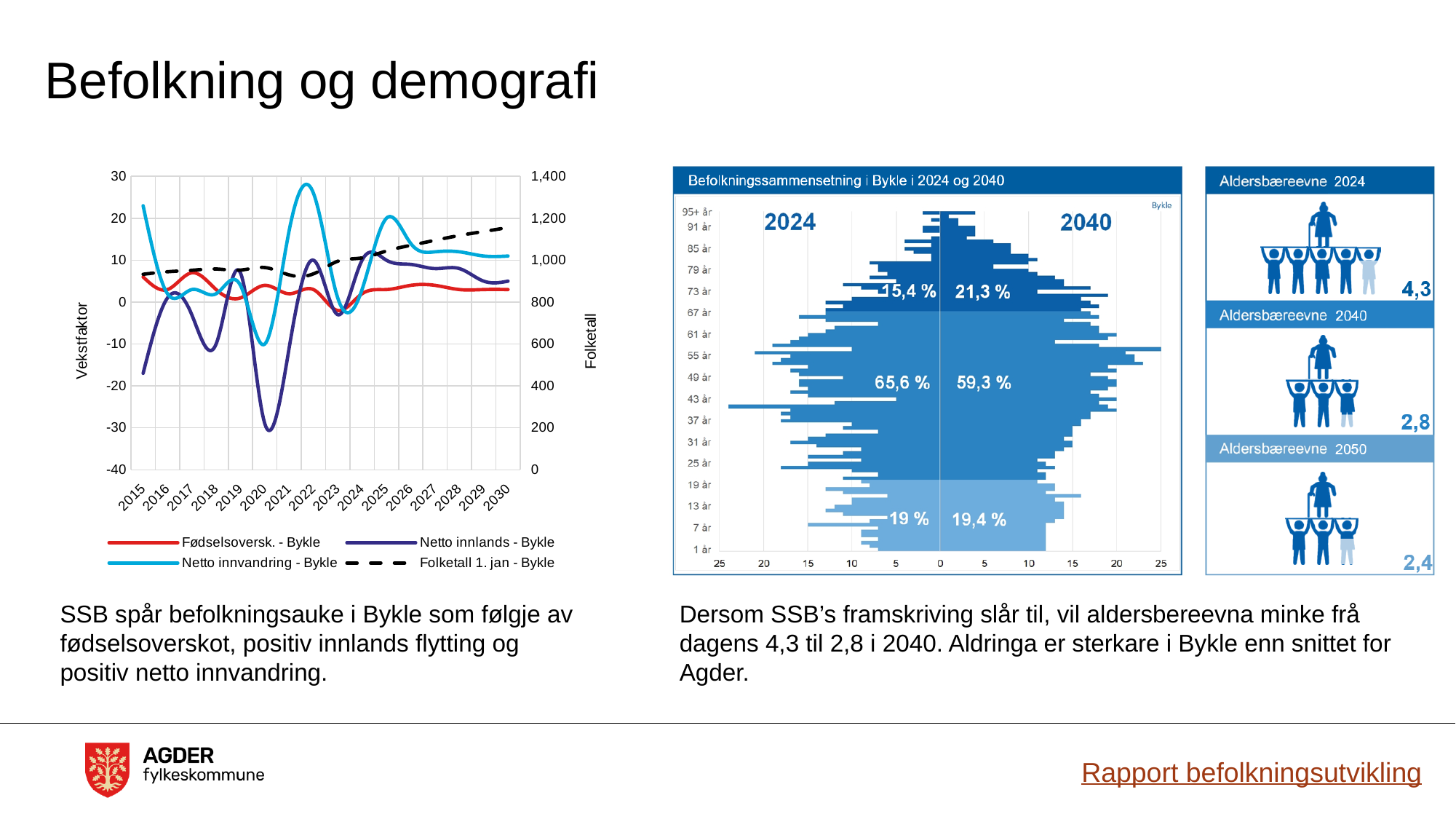
In the Aldersbæreevne panels on the right, what is the difference between the 2024 value and the 2040 value? 1,5 In the chart 'Befolkningssammensetning i Bykle i 2024 og 2040', which year has the larger share in the middle group, 2024 or 2040? 2024 In the left-hand line chart, does the dashed Folketall 1. jan - Bykle line rise or fall from 2015 to 2030? rise In the Aldersbæreevne panels on the right, what is the value for 2050? 2,4 In the chart 'Befolkningssammensetning i Bykle i 2024 og 2040', by how many percentage points does the oldest group's share in 2040 exceed its share in 2024? 5,9 percentage points In the left-hand line chart, is the Folketall 1. jan - Bykle value in 2030 greater or less than 1,000 on the right axis? greater How many series does the legend of the left-hand line chart list? 4 In the left-hand line chart, is the value for Netto innvandring - Bykle in 2022 greater or less than 20? greater In the chart 'Befolkningssammensetning i Bykle i 2024 og 2040', what share of the population is in the middle (working-age) group in 2024? 65,6 % What kind of chart is the left-hand chart with the Vekstfaktor axis? line chart In the chart 'Befolkningssammensetning i Bykle i 2024 og 2040', what share of the population is in the oldest group in 2040? 21,3 % In the left-hand line chart, is the value for Netto innlands - Bykle in 2020 greater or less than -20? less